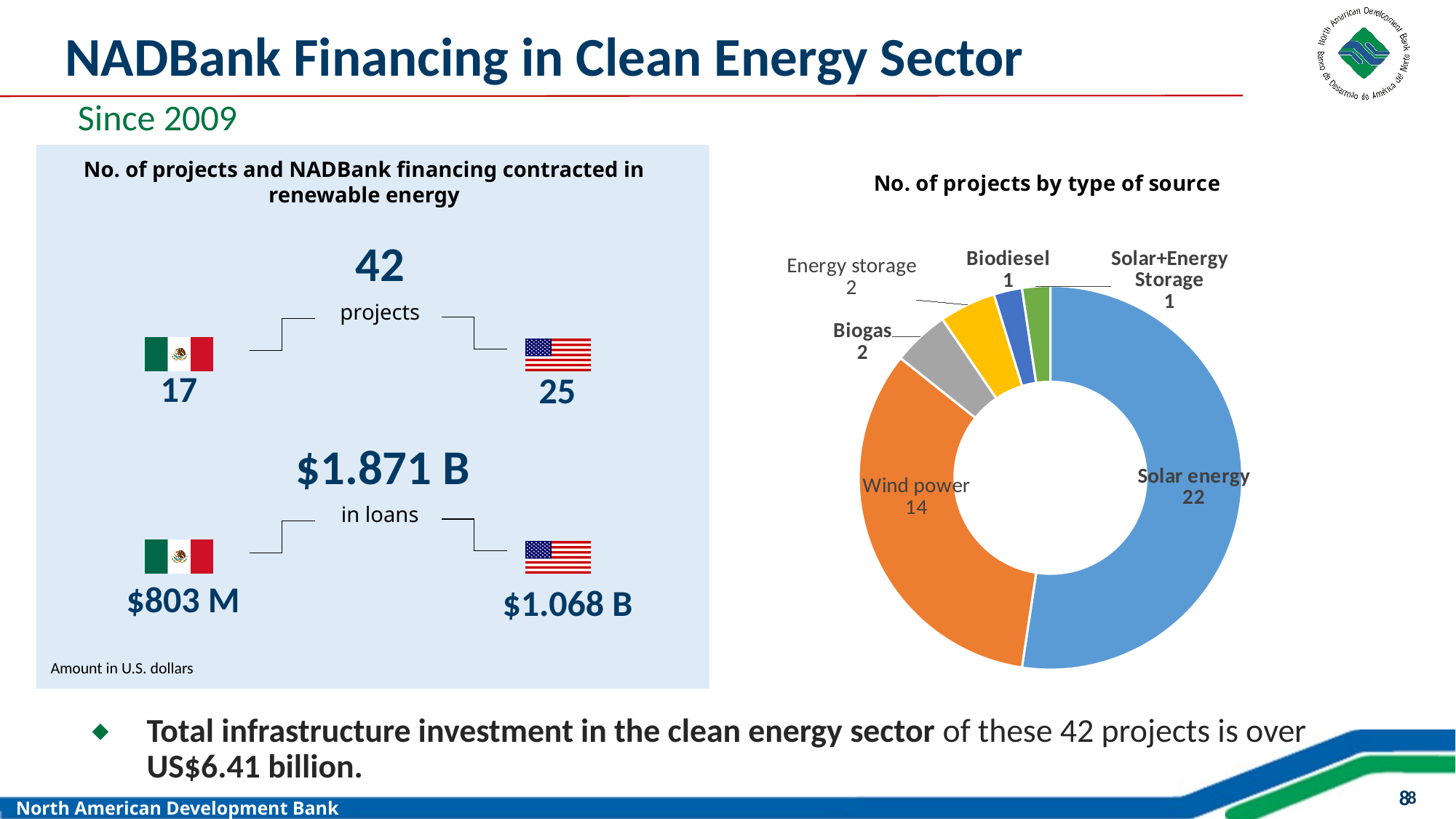
What type of chart is used to show the number of projects by type of source? Doughnut (pie) chart In the 'No. of projects by type of source' chart, how many projects are Biodiesel? 1 In the 'No. of projects by type of source' chart, how many projects are Wind power? 14 In the 'No. of projects by type of source' chart, which source type has the most projects? Solar energy In the 'No. of projects by type of source' chart, how many projects are Solar energy? 22 How many source types (slices) are shown in the 'No. of projects by type of source' chart? 6 In the 'No. of projects by type of source' chart, how many more projects are Solar energy than Wind power? 8 What is the total number of projects across all slices in the 'No. of projects by type of source' chart? 42 In the 'No. of projects by type of source' chart, which has more projects: Wind power or Biogas? Wind power In the 'No. of projects by type of source' chart, how many projects are Biogas? 2 What is the title of the doughnut chart on the slide? No. of projects by type of source In the 'No. of projects by type of source' chart, what colour is the Wind power slice? Orange